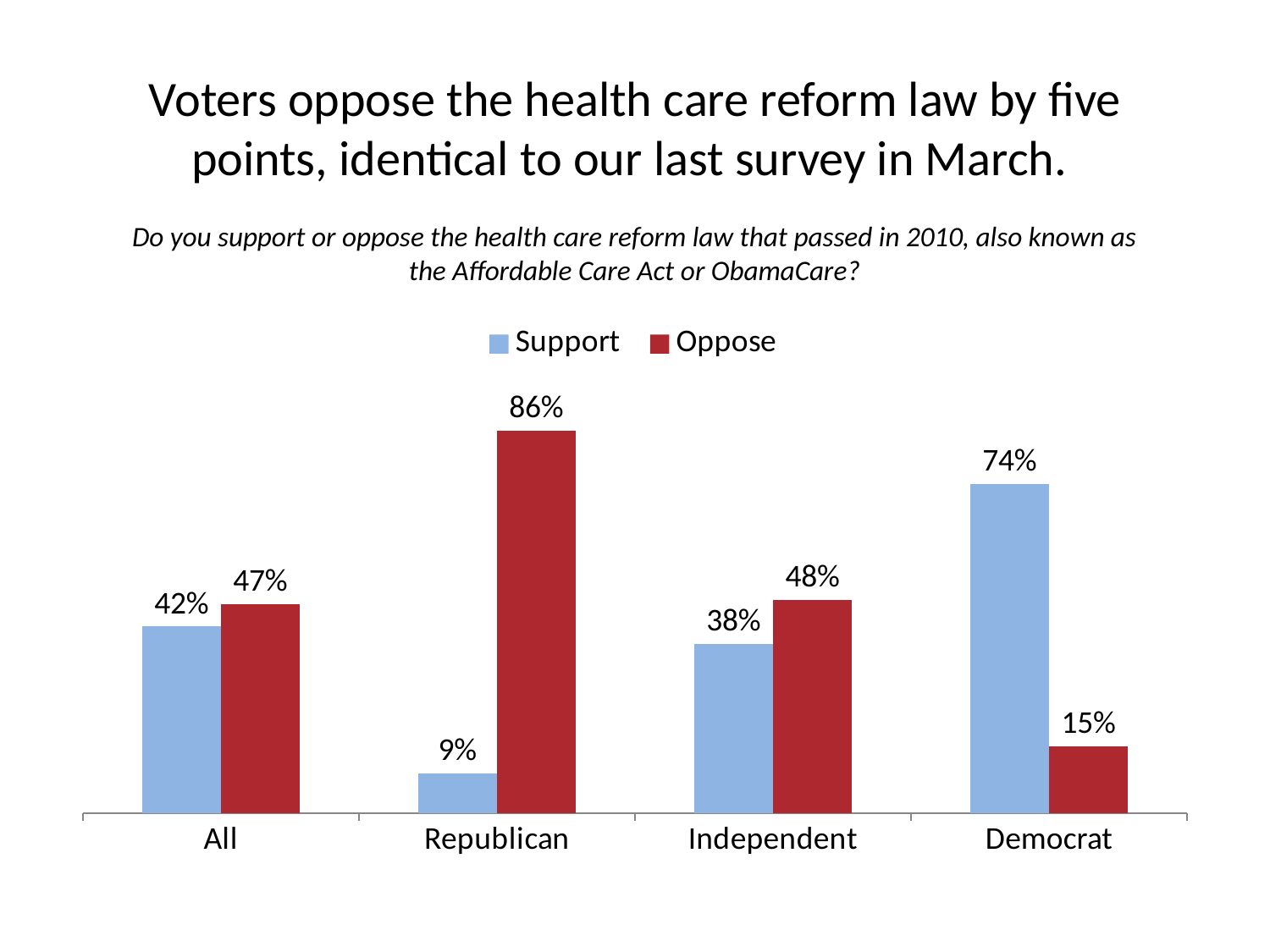
Which category has the lowest Oppose value? Democrat What percentage of Republicans oppose the health care reform law? 86% Among Independents, is the Support value or the Oppose value larger? Oppose What is the Oppose value for the All category? 47% How many series does the legend list? 2 What is the difference between the Oppose and Support values for Republicans? 77 percentage points Which colour represents the Oppose series? Red What is the Support value for Independents? 38% What percentage of Democrats support the health care reform law? 74% How many categories are shown on the x axis? 4 What kind of chart is shown on the slide? Bar chart Which category has the highest Support value? Democrat